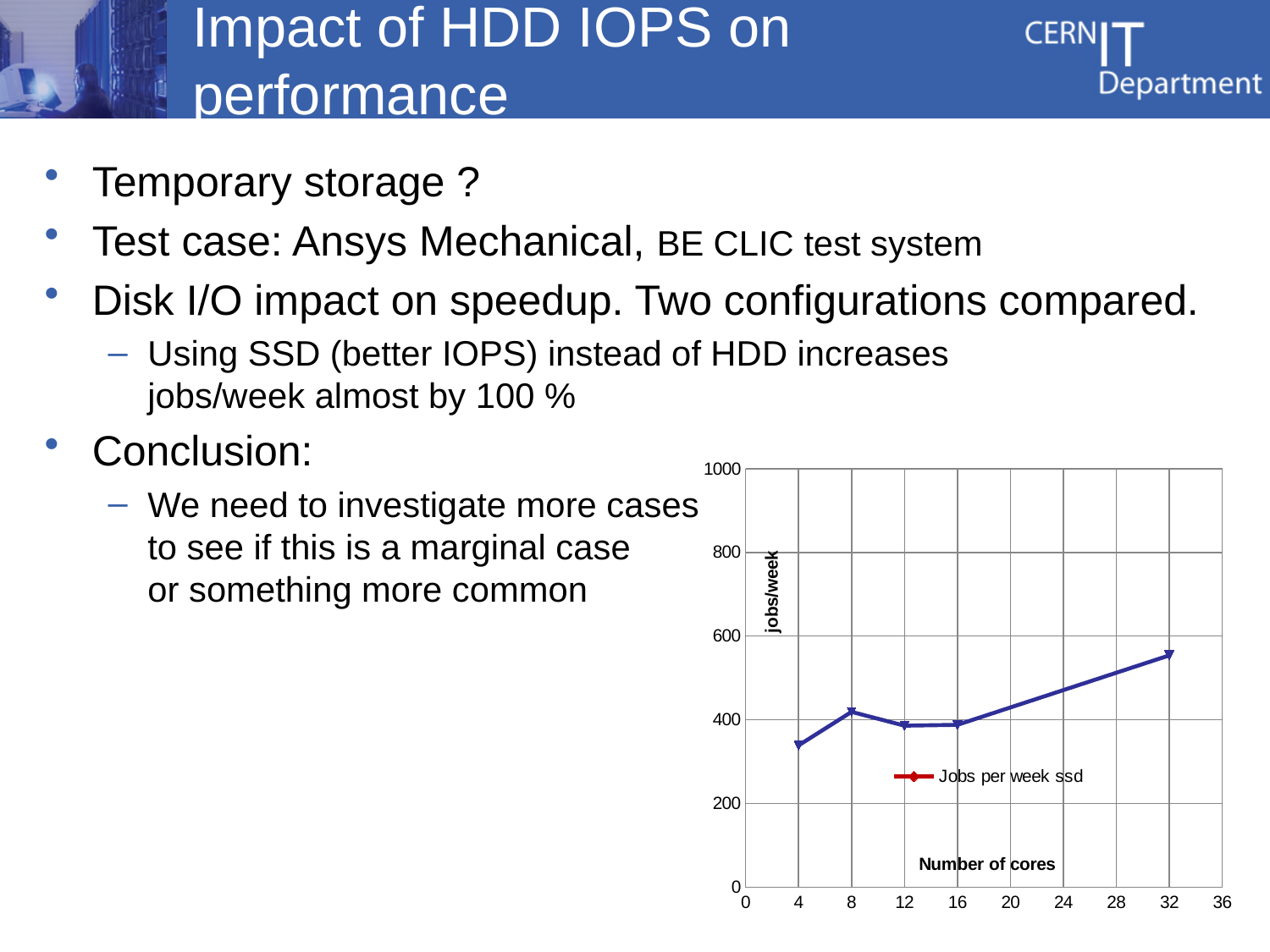
At which number of cores is jobs/week lowest? 4 Does jobs/week rise or fall between 16 cores and 32 cores? rise Is the jobs/week value at 8 cores greater or less than 400? greater Is the jobs/week value at 32 cores greater or less than 600? less How many series does the legend list? 1 At which number of cores is jobs/week highest? 32 Is the jobs/week value at 4 cores greater or less than 400? less What is the label of the y axis? jobs/week What is the legend entry for the plotted series? Jobs per week ssd Which has the higher jobs/week value: 4 cores or 32 cores? 32 cores How many data points are plotted on the line? 5 What kind of chart is shown on the slide? line chart